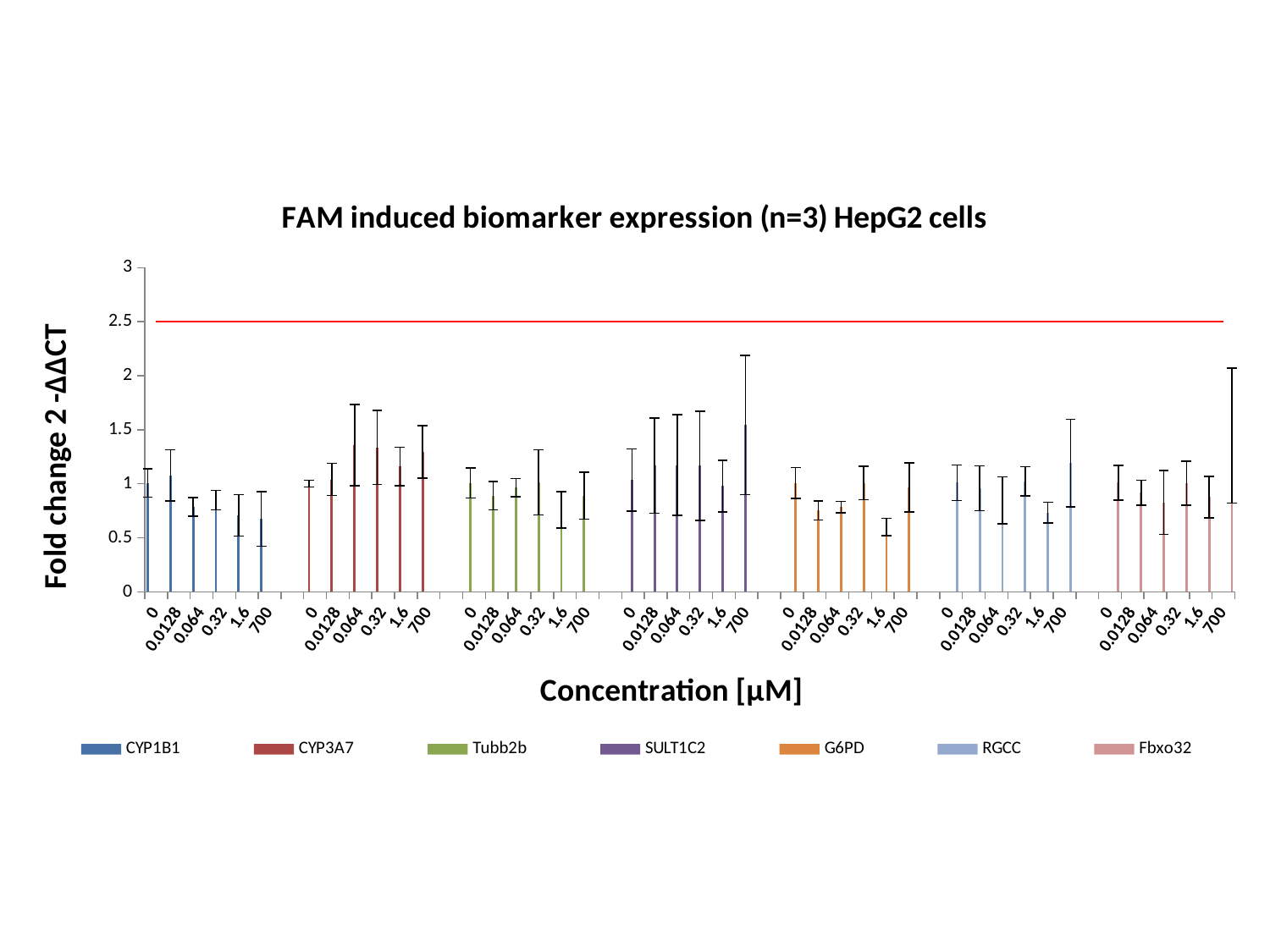
Is the value for G6PD at 1.6 µM greater or less than 1? less Which concentration has the highest value for the SULT1C2 series? 700 How many concentration categories are plotted for each biomarker series? 6 Which is larger: CYP3A7 at 0.32 µM or CYP1B1 at 1.6 µM? CYP3A7 at 0.32 µM What is the title of the chart? FAM induced biomarker expression (n=3) HepG2 cells At what fold change value is the red horizontal line drawn? 2.5 Is the value for CYP1B1 at 1.6 µM greater or less than 1? less How many series does the legend list? 7 Which concentration has the lowest value for the CYP1B1 series? 700 Is the value for SULT1C2 at 700 µM greater or less than 1? greater What kind of chart is shown on the slide? bar chart